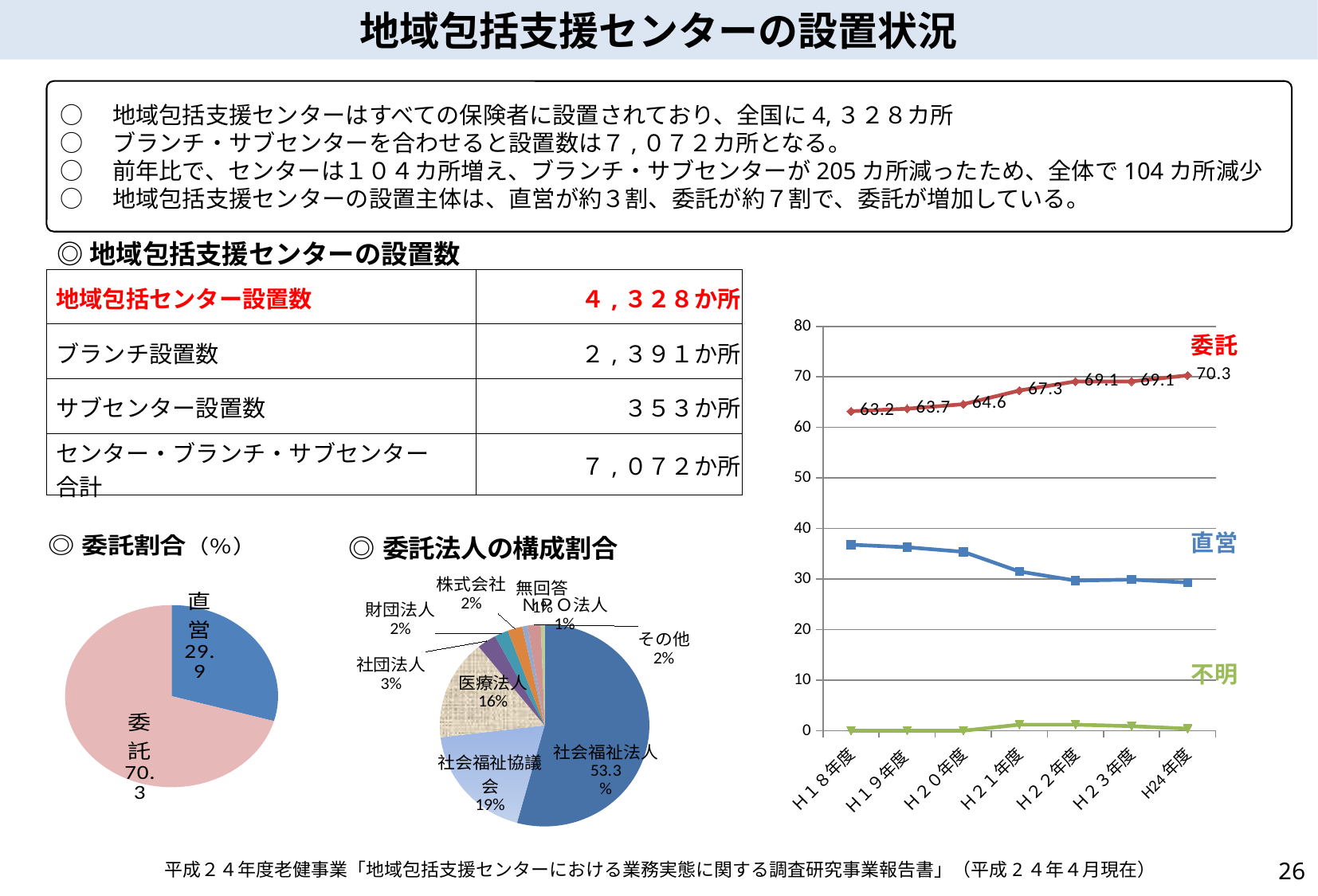
In the 委託法人の構成割合 pie chart, what is the share for 社会福祉協議会? 19% In the 委託割合（%） pie chart, what share does 委託 have? 70.3 In the line chart on the right, does the 委託 series rise or fall from H１８年度 to H24年度? rise In the line chart on the right, by how much did the 委託 value increase from H１８年度 to H24年度? 7.1 In the line chart on the right, what is the value for 委託 in H１８年度? 63.2 In the line chart on the right, how many series are plotted? 3 In the line chart on the right, what is the value for 委託 in H24年度? 70.3 In the 委託法人の構成割合 pie chart, which category has the largest share? 社会福祉法人 In the 委託法人の構成割合 pie chart, which is larger, 医療法人 or 社会福祉協議会? 社会福祉協議会 What kind of chart is the chart on the right side of the slide? line chart In the line chart on the right, is the value for 直営 in H１８年度 greater or less than 40? less In the line chart on the right, how many fiscal years are shown on the x axis? 7